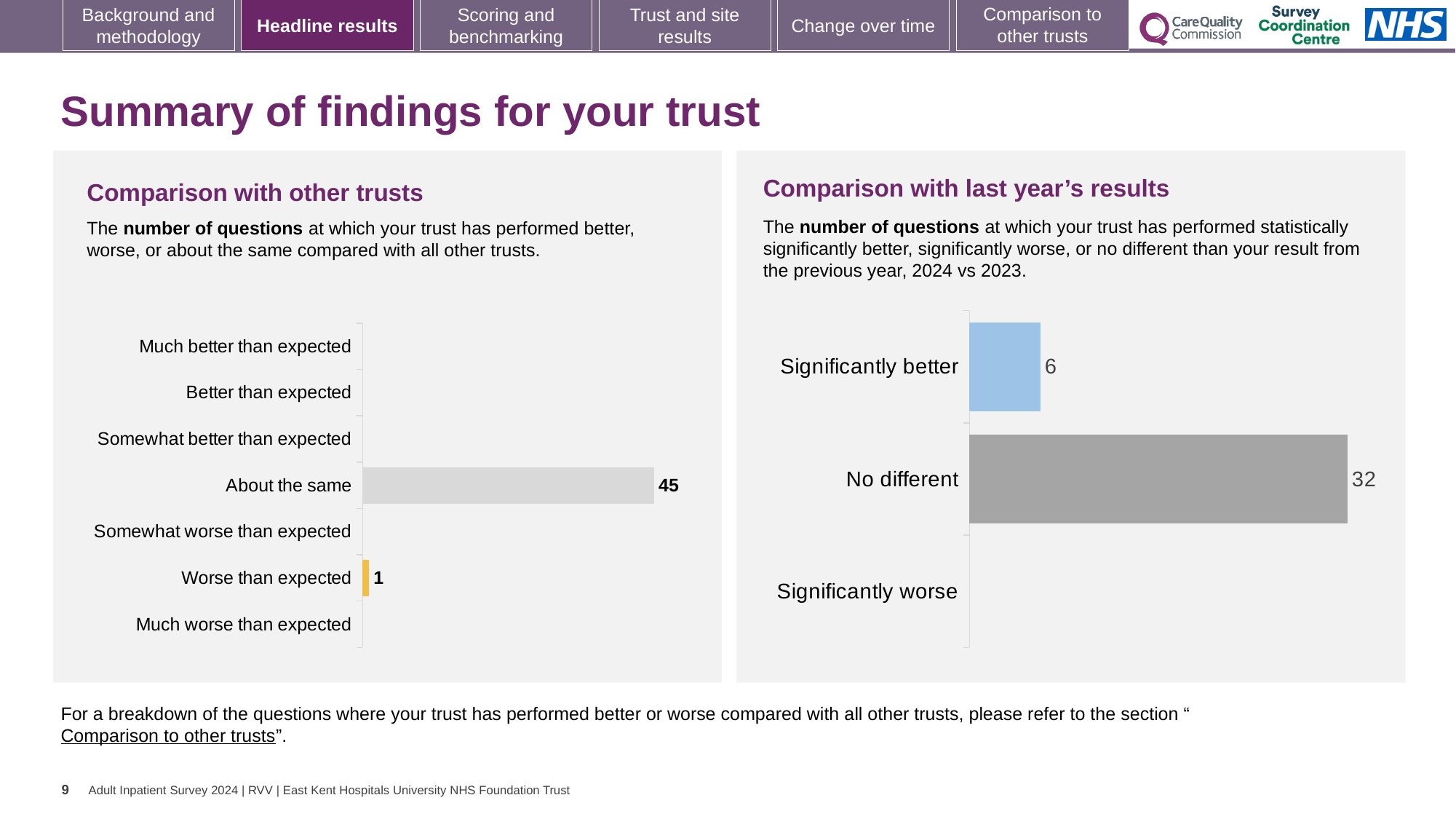
In the 'Comparison with other trusts' chart, what is the difference between 'About the same' and 'Worse than expected'? 44 In the 'Comparison with other trusts' chart, what is the value for 'Worse than expected'? 1 In the 'Comparison with last year's results' chart, what is the value for 'No different'? 32 In the 'Comparison with other trusts' chart, which category has the highest value? About the same In the 'Comparison with last year's results' chart, what is the difference between 'No different' and 'Significantly better'? 26 What kind of chart is the 'Comparison with other trusts' chart? Bar chart How many categories are listed on the 'Comparison with other trusts' chart? 7 In the 'Comparison with last year's results' chart, what colour is the 'Significantly better' bar? Light blue In the 'Comparison with other trusts' chart, what is the value for 'About the same'? 45 In the 'Comparison with last year's results' chart, which category has the highest value? No different How many categories are listed on the 'Comparison with last year's results' chart? 3 In the 'Comparison with last year's results' chart, what is the value for 'Significantly better'? 6